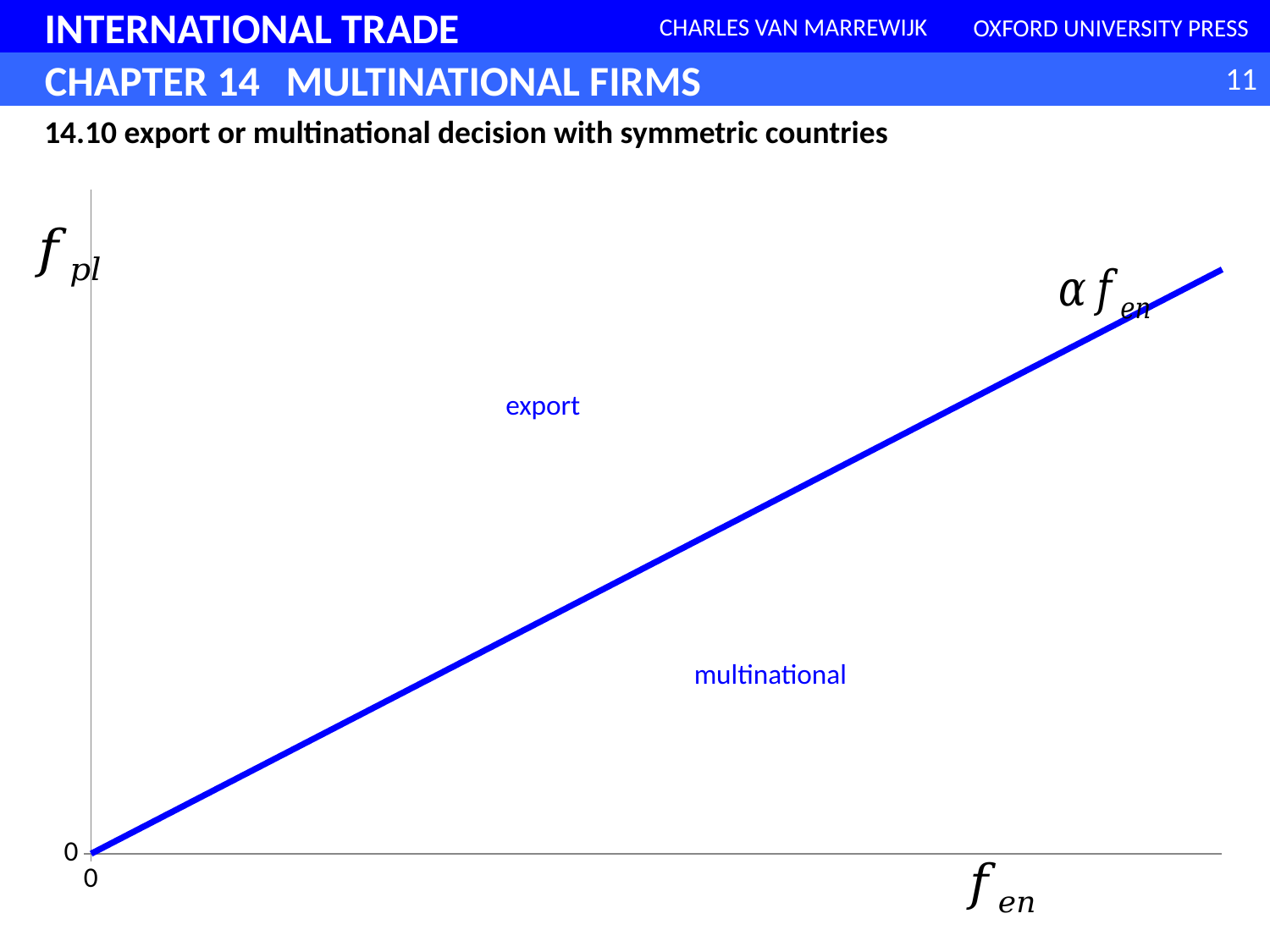
How many lines are plotted on the chart? 1 Which region label appears above the line, and which appears below it? export above, multinational below What kind of chart is shown on the slide? line chart Does the plotted line rise or fall as f_en increases along the x axis? rises What is the label on the horizontal axis of the chart? f_en